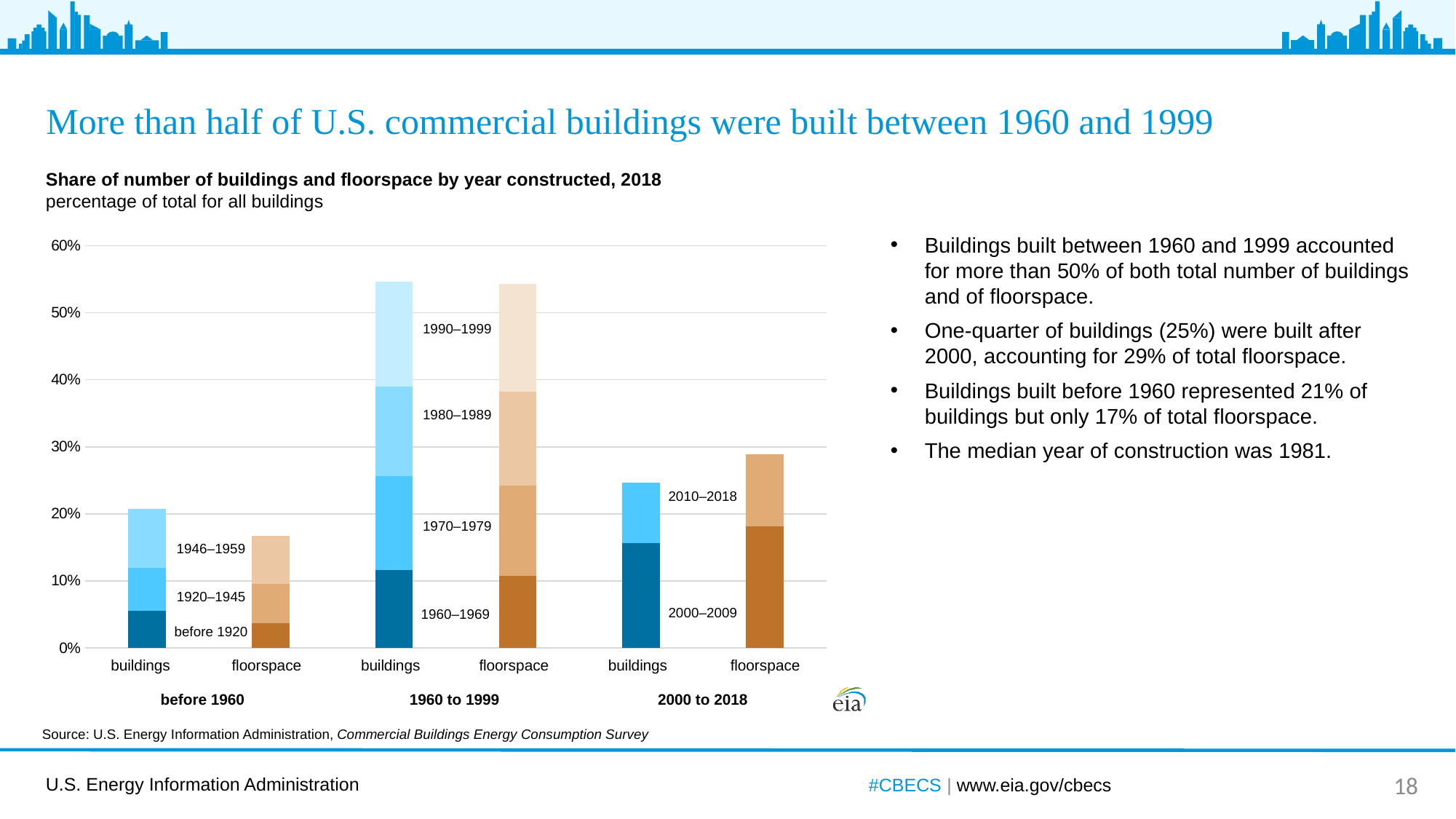
Which construction period group has the tallest bars? 1960 to 1999 Which bar is the lowest in the chart? floorspace, before 1960 What kind of chart is shown on the slide? Stacked bar chart How many bars are plotted in the chart? 6 Is the value for buildings in the 1960 to 1999 group greater or less than 50%? greater Is the value for floorspace in the before 1960 group greater or less than 20%? less Is the value for buildings in the 2000 to 2018 group greater or less than 30%? less In the before 1960 group, which is larger: buildings or floorspace? buildings Which three segments make up the bars in the before 1960 group? before 1920, 1920–1945, 1946–1959 What is the title of the chart? Share of number of buildings and floorspace by year constructed, 2018 In the 2000 to 2018 group, which is larger: buildings or floorspace? floorspace